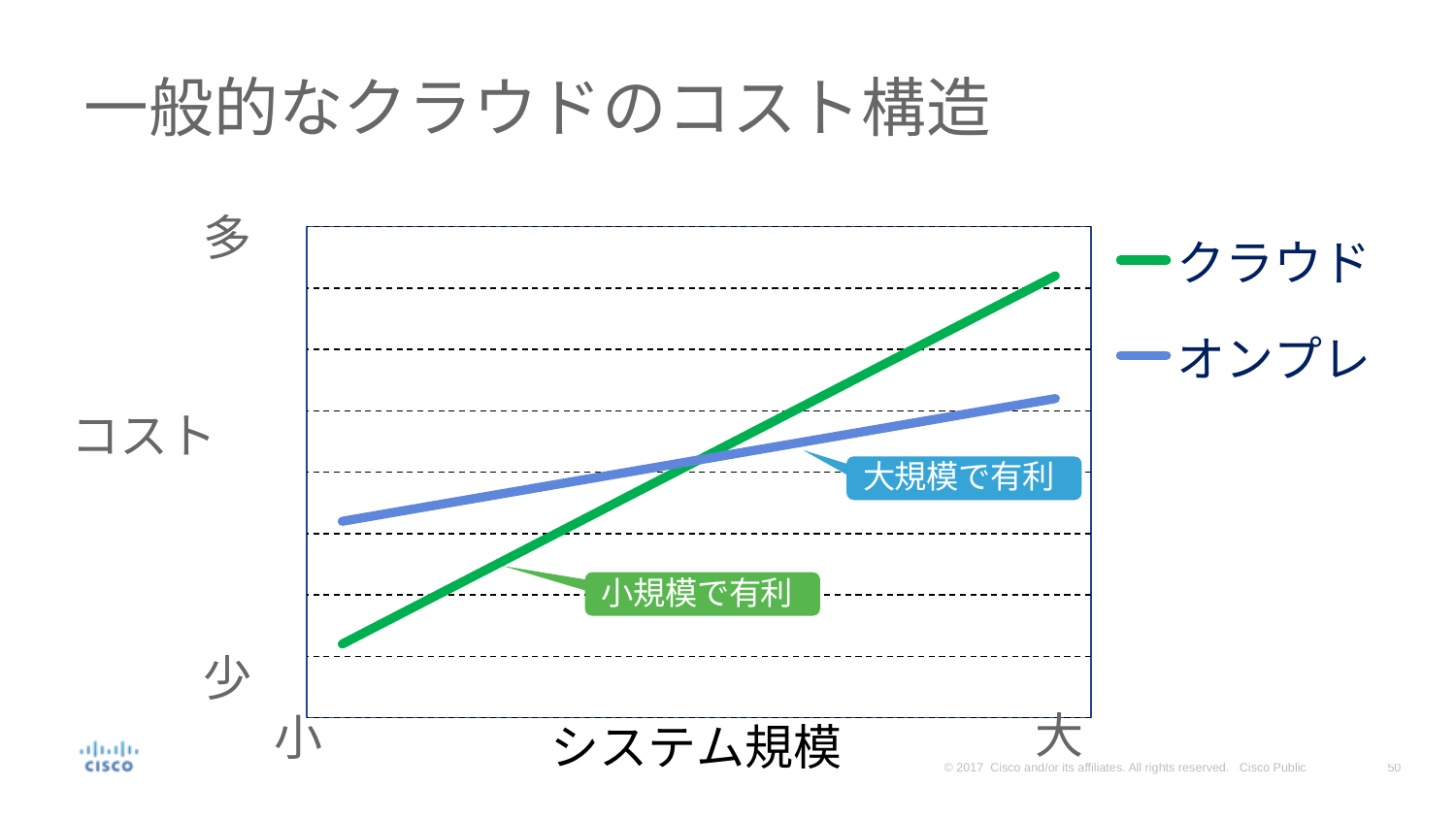
How many series does the legend list? 2 Which series is labelled with the callout 小規模で有利? クラウド Which series is labelled with the callout 大規模で有利? オンプレ Does the cost for オンプレ rise or fall as システム規模 increases from 小 to 大? rise Does the cost for クラウド rise or fall as システム規模 increases from 小 to 大? rise At the small end of システム規模 (小), which series has the lower cost, クラウド or オンプレ? クラウド What kind of chart is shown on the slide? line chart Which series is drawn in green in the legend? クラウド What is the title of the chart on the slide? 一般的なクラウドのコスト構造